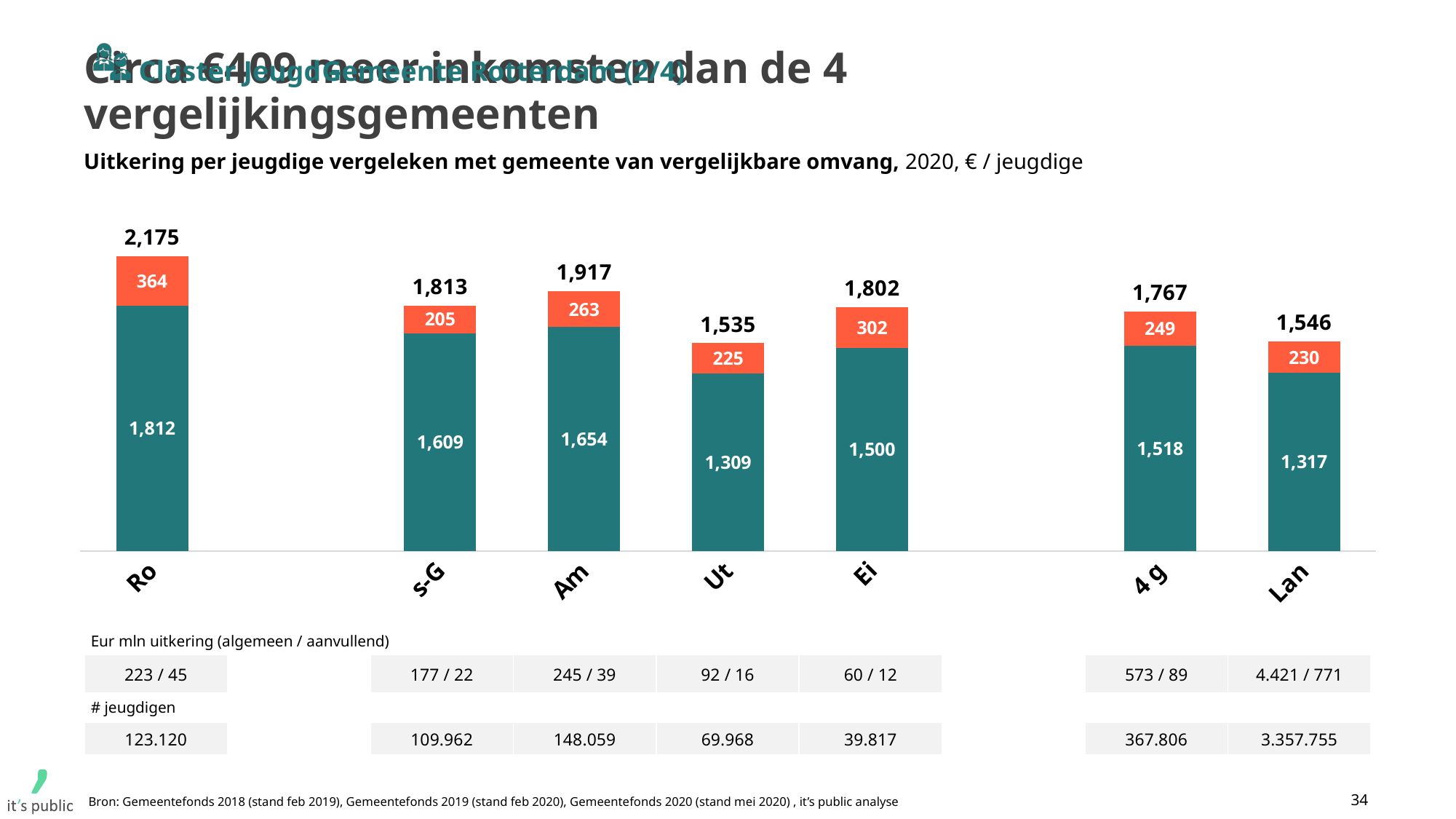
What kind of chart is shown on the slide? Stacked bar chart What is the value of the teal (bottom) segment for Lan? 1,317 Which category has the lowest total value? Ut What is the total value labelled above the bar for Ro? 2,175 How many categories are shown on the x axis of the chart? 7 Which category has the smallest orange (top) segment? s-G What is the value of the teal (bottom) segment for Am? 1,654 Which has the larger total value, Am or Ei? Am Which category has the highest total value? Ro What is the difference between the teal (bottom) segment values for Ro and Am? 158 What is the difference between the orange (top) segment values for Ro and Ei? 62 What is the value of the orange (top) segment for Ei? 302